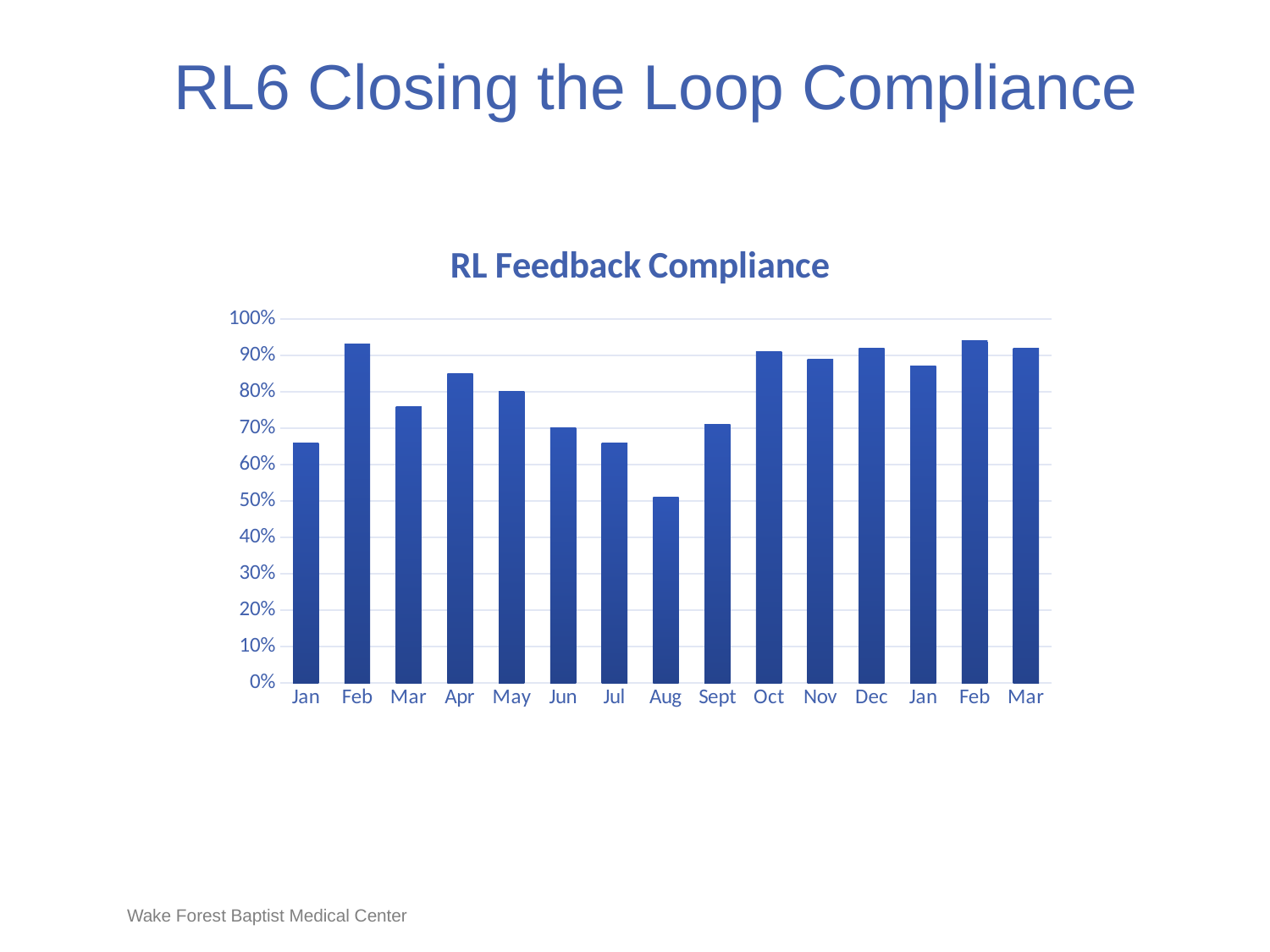
Is the value for Apr greater or less than 80%? greater How many bars are plotted in the chart? 15 What kind of chart is shown on the slide? bar chart What is the title of the chart? RL Feedback Compliance Which month has the lowest compliance value? Aug Is the value for Aug greater or less than 60%? less Is the value for the first Mar bar greater or less than 70%? greater Which is larger, the value for Apr or the value for May? Apr Which is larger, the value for Aug or the value for Sept? Sept Do the values rise or fall from Aug to Oct? rise Do the values rise or fall from Apr to Aug? fall